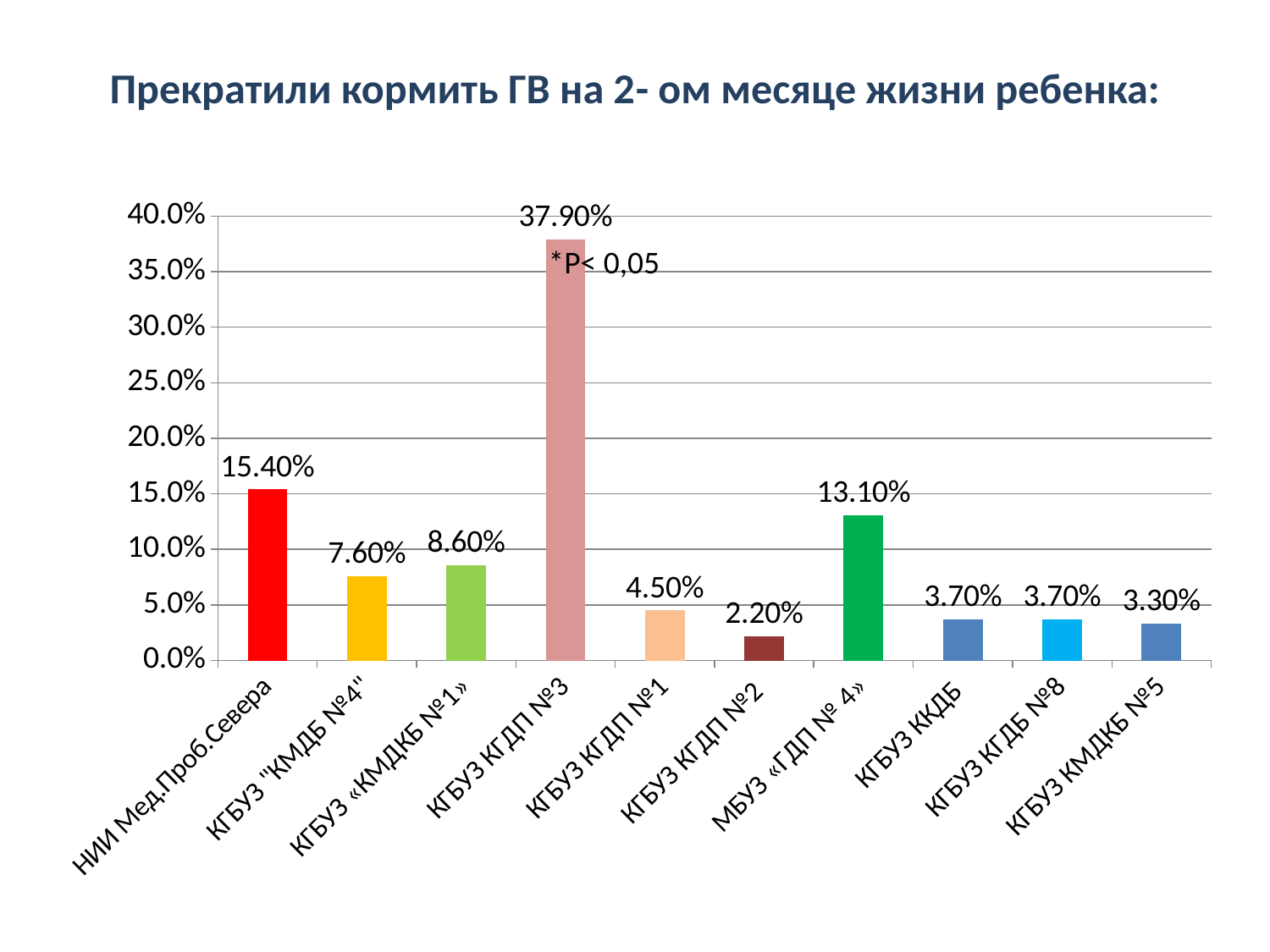
What is the title of the chart? Прекратили кормить ГВ на 2- ом месяце жизни ребенка: Is the value for МБУЗ «ГДП № 4» greater or less than 10.0%? greater Which category has the highest value? КГБУЗ КГДП №3 What is the value for МБУЗ «ГДП № 4»? 13.10% How many categories are shown on the x axis? 10 What is the value for НИИ Мед.Проб.Севера? 15.40% What is the value for КГБУЗ КГДП №2? 2.20% What kind of chart is shown on the slide? bar chart Which is larger, the value for КГБУЗ «КМДКБ №1» or the value for КГБУЗ "КМДБ №4"? КГБУЗ «КМДКБ №1» Which category has the lowest value? КГБУЗ КГДП №2 What is the difference between the values for КГБУЗ КГДП №3 and НИИ Мед.Проб.Севера? 22.50% What is the value for КГБУЗ КГДП №3? 37.90%